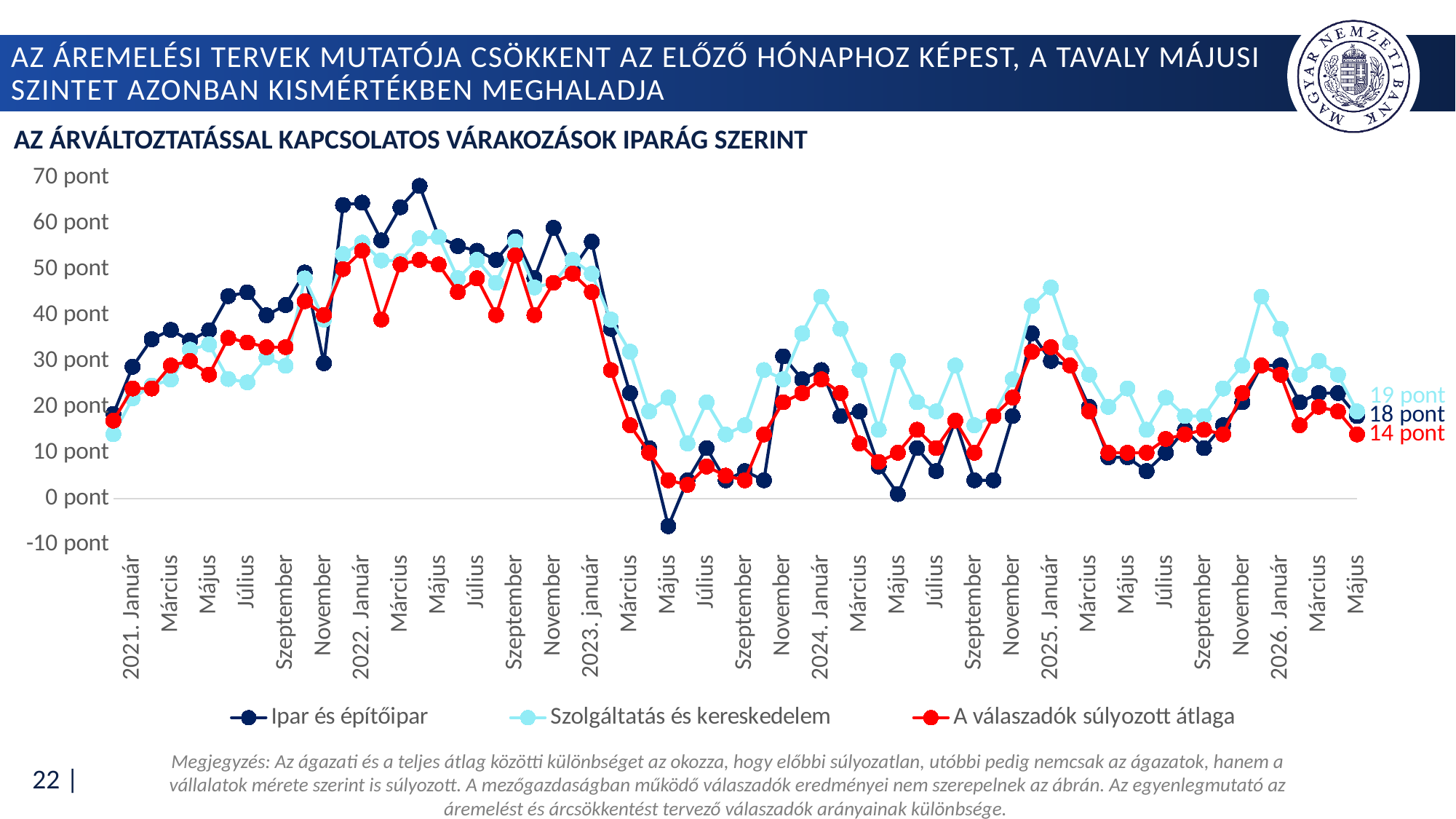
Which series reaches the highest value anywhere on the chart? Ipar és építőipar What is the latest (Május 2026) value labelled for Ipar és építőipar? 18 pont Does the Ipar és építőipar series rise or fall between 2021. Január and Május 2022? rise Is the value for Szolgáltatás és kereskedelem in 2024. Január greater or less than 40 pont? greater At the last data point, what is the difference between the Szolgáltatás és kereskedelem value and the A válaszadók súlyozott átlaga value? 5 pont What is the title of the chart? AZ ÁRVÁLTOZTATÁSSAL KAPCSOLATOS VÁRAKOZÁSOK IPARÁG SZERINT What is the latest (Május 2026) value labelled for A válaszadók súlyozott átlaga? 14 pont At the last data point, which series is higher: Ipar és építőipar or Szolgáltatás és kereskedelem? Szolgáltatás és kereskedelem What is the latest (Május 2026) value labelled for Szolgáltatás és kereskedelem? 19 pont Is the value for Ipar és építőipar in Május 2023 greater or less than 0 pont? less How many series does the legend list? 3 What kind of chart is shown on the slide? line chart